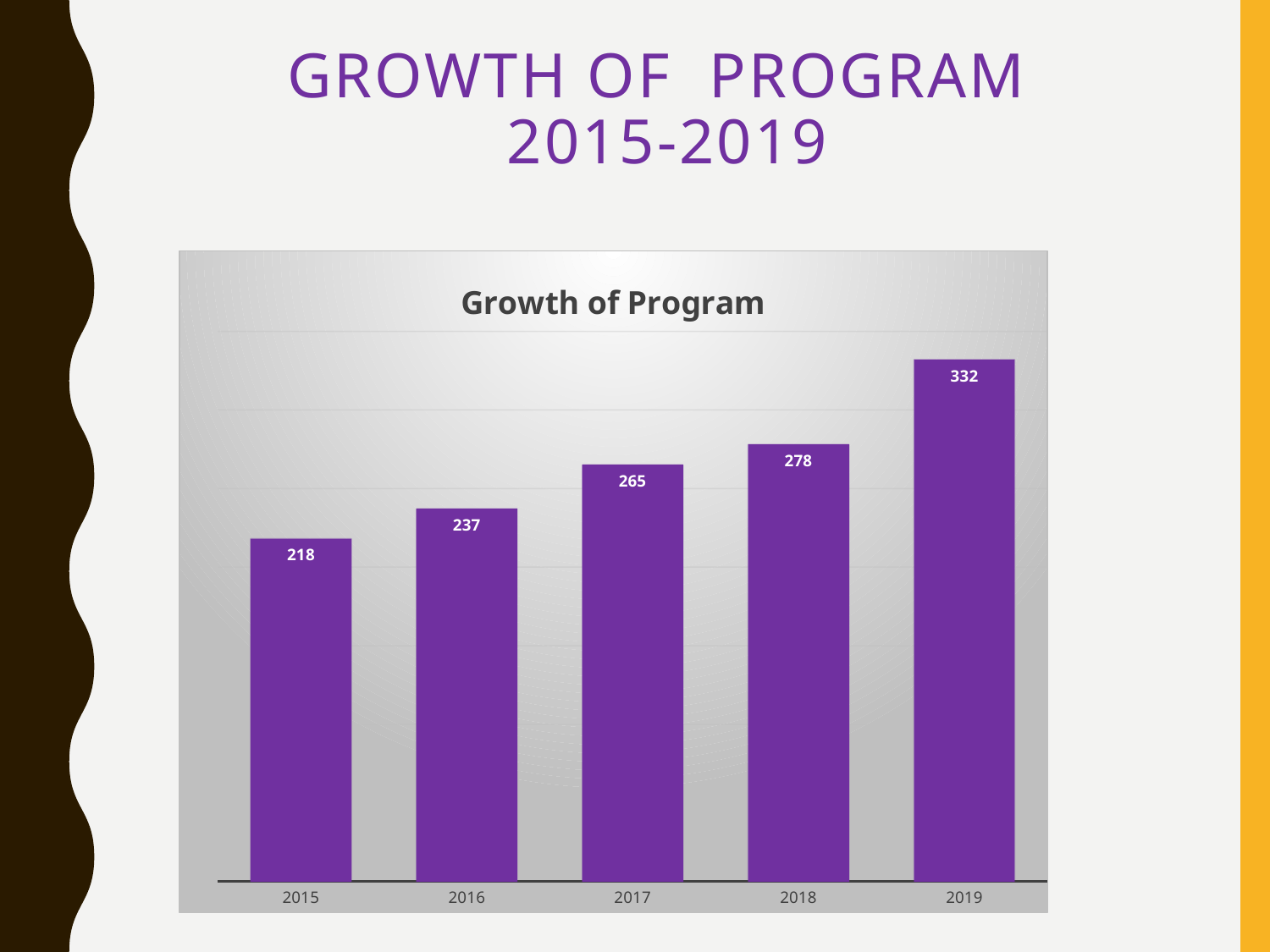
Which year has the highest value? 2019 What kind of chart is this? bar chart What is the difference between the values for 2019 and 2015? 114 What is the value for 2015? 218 What is the value for 2017? 265 Do the values rise or fall from 2015 to 2019? rise What is the title of the chart? Growth of Program What is the value for 2019? 332 Which year has the lowest value? 2015 Which is larger, the value for 2016 or the value for 2018? 2018 How many years are shown on the x axis? 5 What is the difference between the values for 2018 and 2017? 13